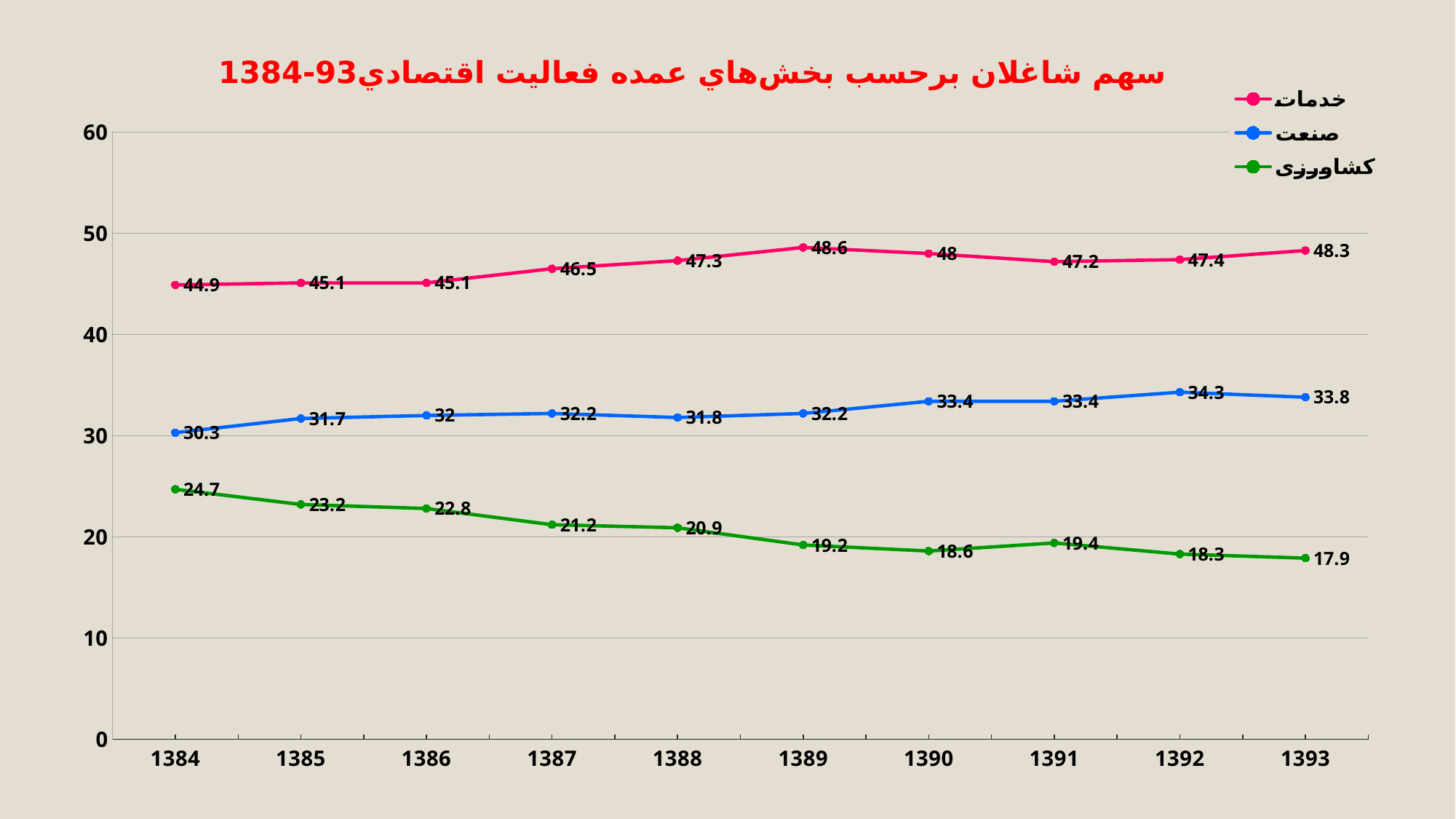
What is the value for خدمات in 1389? 48.6 Which is larger in 1391: the value for صنعت or the value for کشاورزی? صنعت What colour is the line for خدمات? pink Does the value for کشاورزی generally rise or fall from 1384 to 1393? fall What is the value for صنعت in 1384? 30.3 How many years are shown on the x axis? 10 What is the value for کشاورزی in 1393? 17.9 What is the difference between the خدمات value in 1393 and in 1384? 3.4 What type of chart is shown on the slide? line chart In which year is the value for کشاورزی lowest? 1393 In which year is the value for صنعت highest? 1392 How many series does the legend list? 3